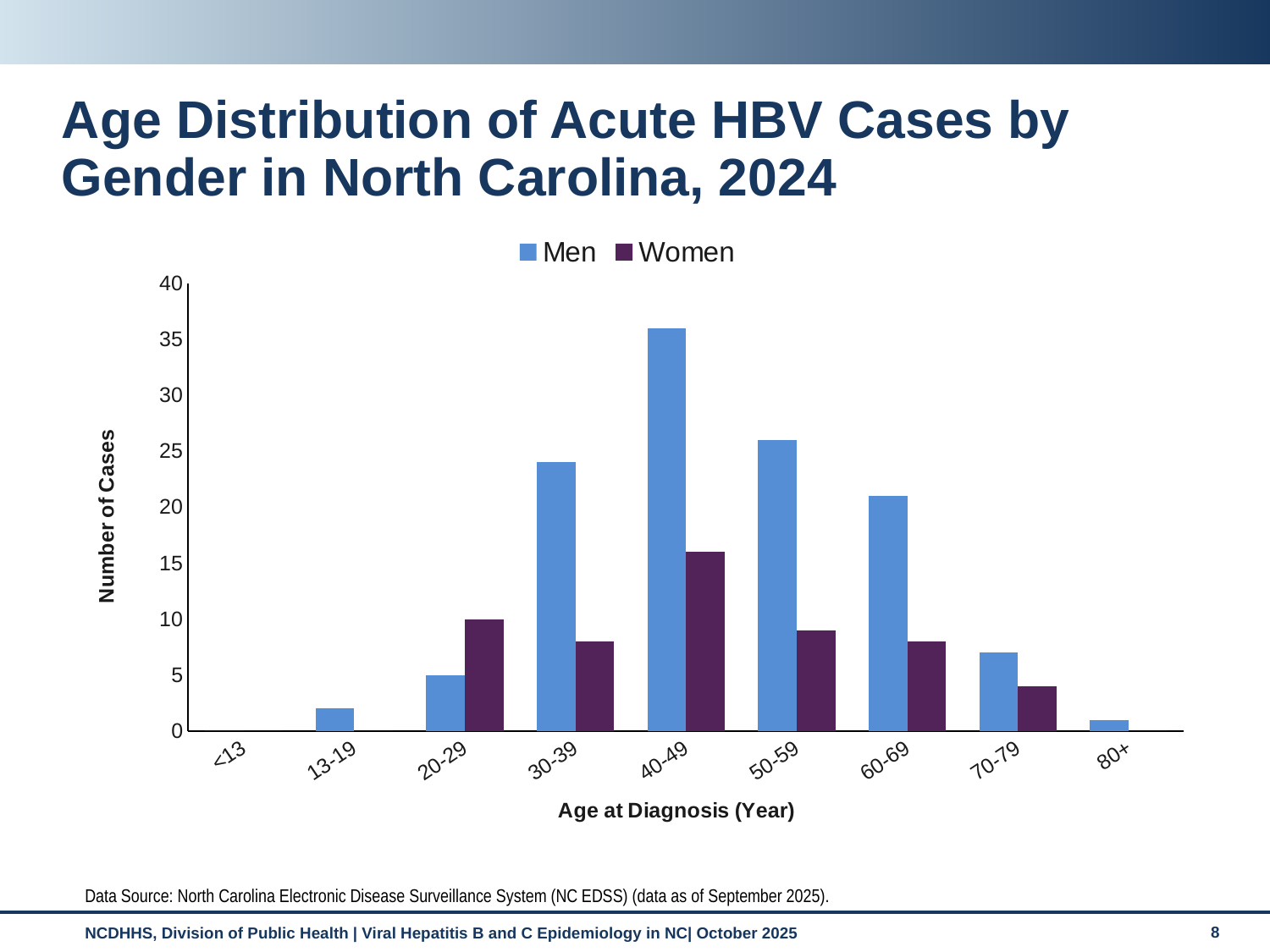
What kind of chart is shown on the slide? bar chart What is the number of cases for Women in the 20-29 age group? 10 What is the difference between the Women and Men values in the 20-29 age group? 5 Which age group has the highest number of cases for Men? 40-49 Which age group has the highest number of cases for Women? 40-49 In the 20-29 age group, which series has more cases, Men or Women? Women Is the value for Women in the 40-49 age group greater or less than 20? less Is the value for Men in the 40-49 age group greater or less than 35? greater What is the number of cases for Men in the 20-29 age group? 5 What is the label of the y axis? Number of Cases How many age categories are shown on the x axis? 9 How many series does the legend list? 2